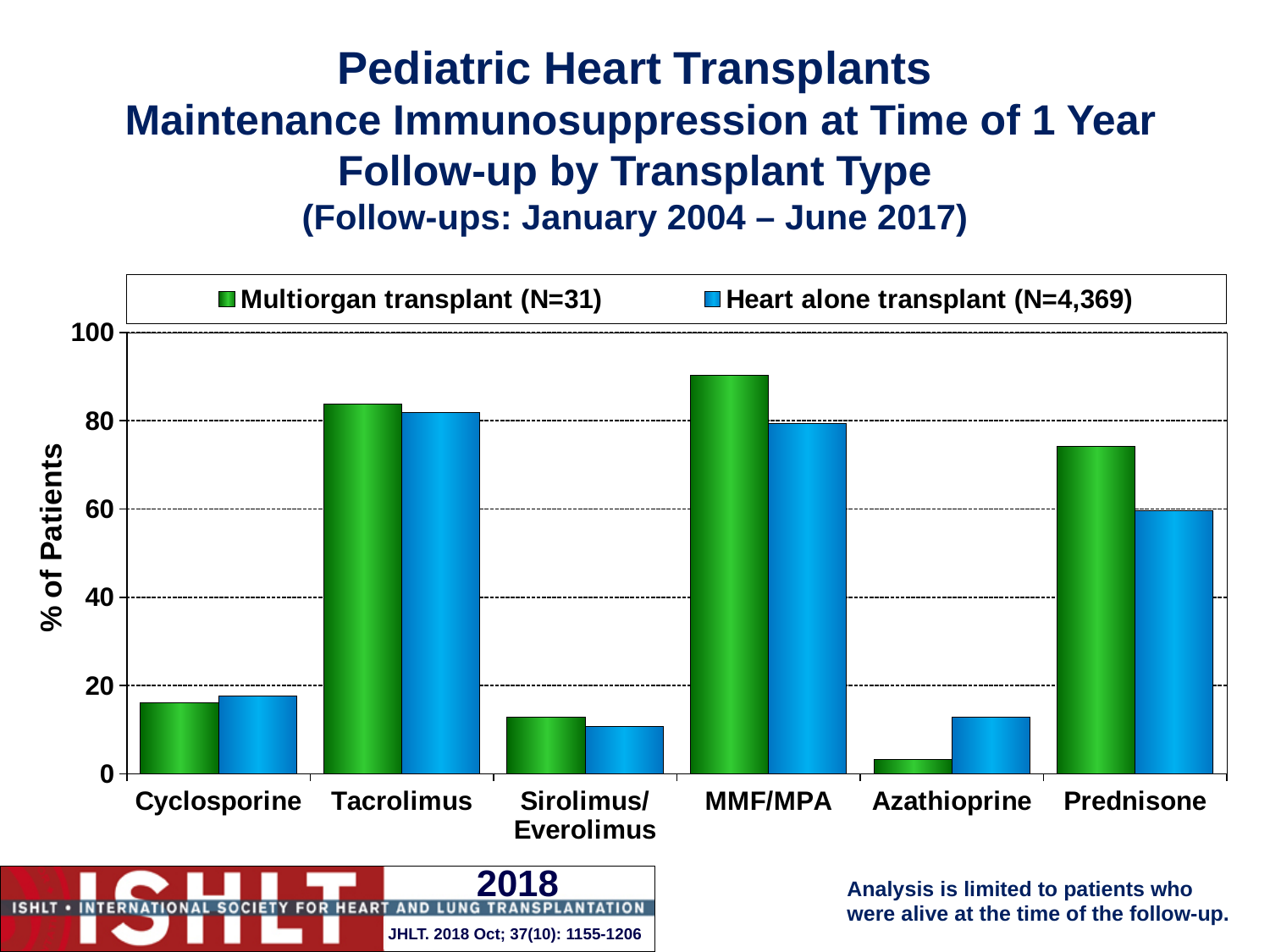
What is the label of the y axis? % of Patients Is the value for Tacrolimus in the Heart alone transplant series greater or less than 60? greater Is the value for Cyclosporine in the Multiorgan transplant series greater or less than 20? less What is the N given in the legend for the Heart alone transplant series? N=4,369 How many series does the legend list? 2 For Prednisone, which series has the larger value: Multiorgan transplant or Heart alone transplant? Multiorgan transplant For Azathioprine, which series has the larger value: Multiorgan transplant or Heart alone transplant? Heart alone transplant Which drug has the highest value for Multiorgan transplant (N=31)? MMF/MPA How many drug categories are shown on the x axis? 6 What kind of chart is shown on the slide? bar chart Is the value for MMF/MPA in the Multiorgan transplant series greater or less than 80? greater Which drug has the lowest value for Multiorgan transplant (N=31)? Azathioprine